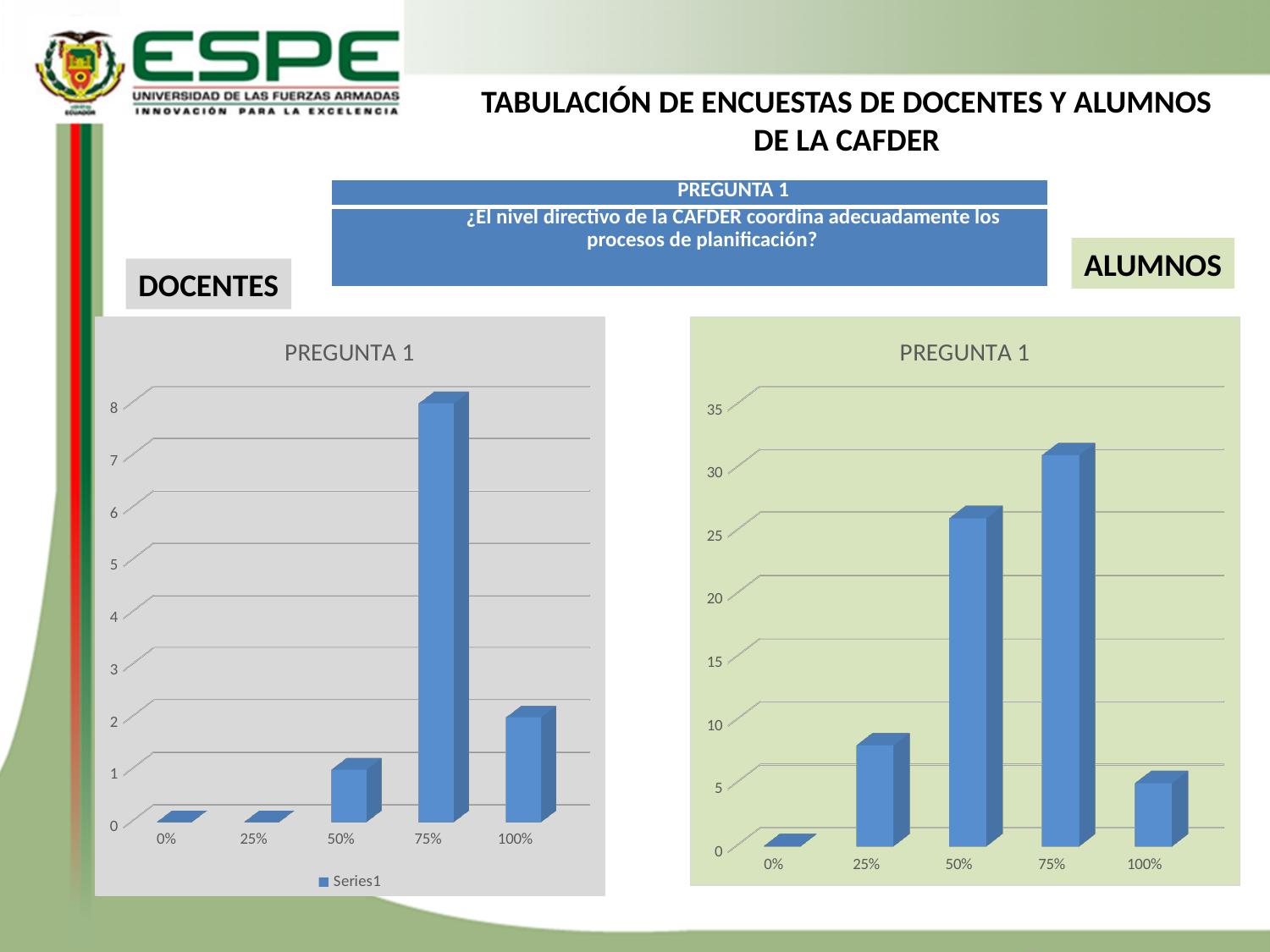
How many categories are shown on the x axis of the DOCENTES chart on the left? 5 In the DOCENTES chart on the left, which category has the highest value? 75% What is the title shown on the ALUMNOS chart on the right? PREGUNTA 1 In the ALUMNOS chart on the right, which category has the highest value? 75% In the DOCENTES chart on the left, which is larger, the value for 50% or the value for 100%? 100% In the ALUMNOS chart on the right, which category has the lowest value? 0% How many series does the legend of the DOCENTES chart on the left list? 1 In the ALUMNOS chart on the right, which is larger, the value for 25% or the value for 50%? 50% What kind of chart is the DOCENTES chart on the left? bar chart In the ALUMNOS chart on the right, is the value for 50% greater or less than 20? greater In the DOCENTES chart on the left, is the value for 100% greater or less than 4? less In the DOCENTES chart on the left, is the value for 75% greater or less than 6? greater